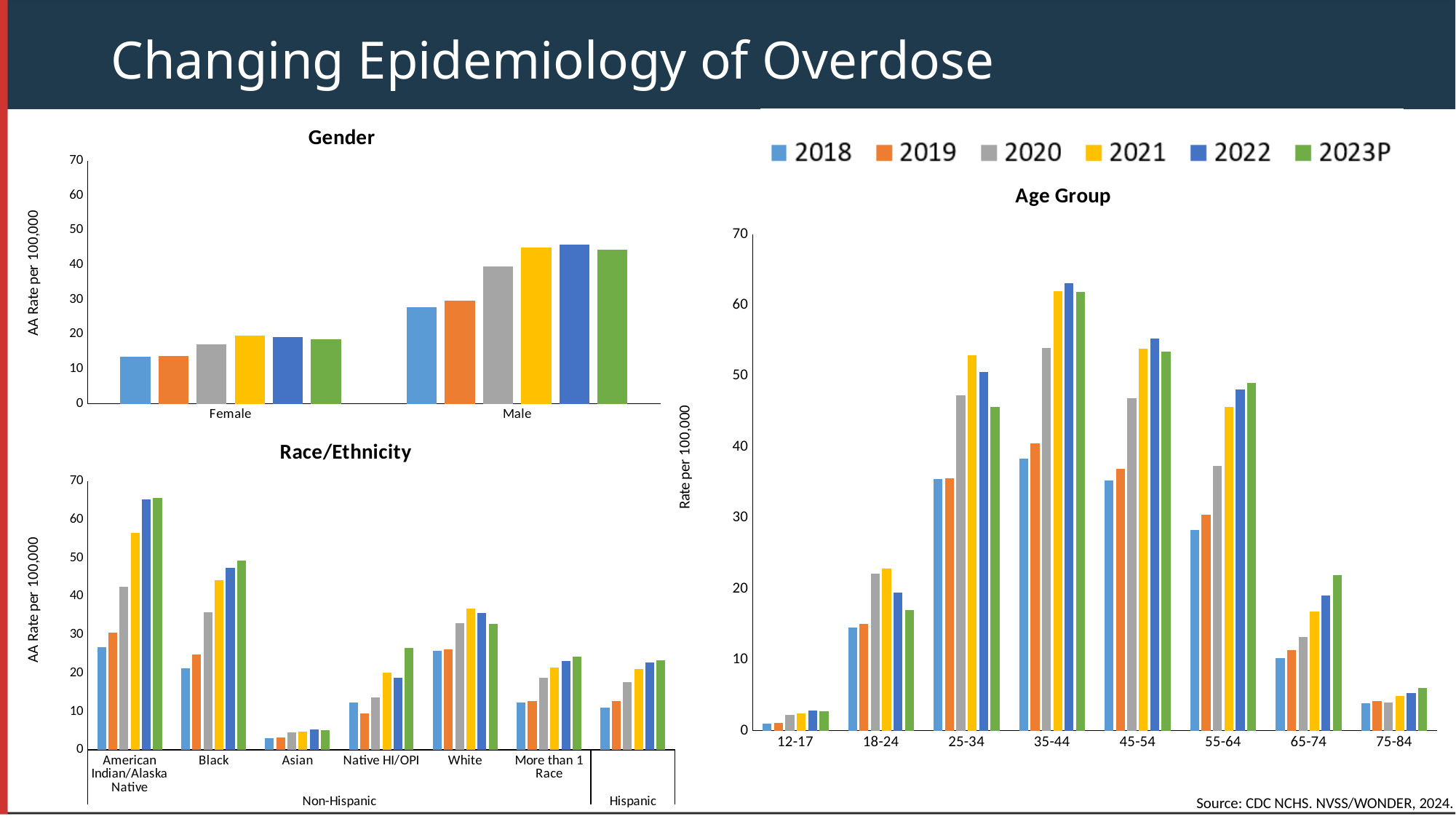
In the Age Group chart, which age group has the highest value? 35-44 In the Race/Ethnicity chart, which category has the highest value? American Indian/Alaska Native How many age groups are shown in the Age Group chart? 8 In the Age Group chart, do the values for the 65-74 age group rise or fall from 2018 to 2023P? rise How many series does the legend at the top of the slide list? 6 In the Gender chart, is the value for Male in 2022 greater or less than 40? greater In the Race/Ethnicity chart, which category has the lowest values? Asian What kind of chart is the Gender chart? bar chart In the Race/Ethnicity chart, is the value for Black in 2023P greater or less than 40? greater In the Gender chart, which category has the higher values, Female or Male? Male In the Gender chart, is the value for Female in 2018 greater or less than 20? less How many race/ethnicity categories are shown in the Race/Ethnicity chart? 7